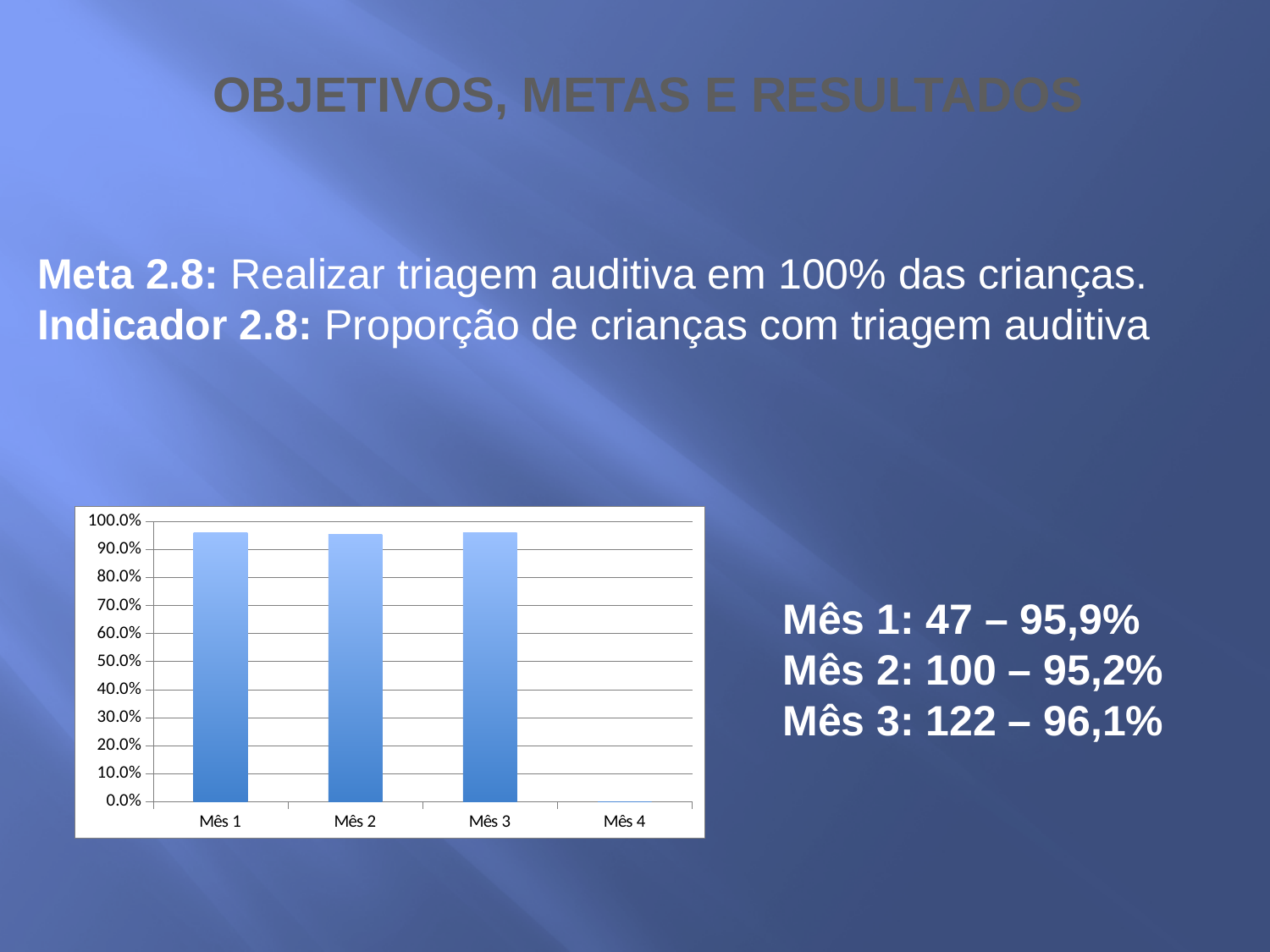
What is the value for Mês 3? 96,1% What is the difference between the values for Mês 3 and Mês 2? 0,9% What kind of chart is shown on the slide? bar chart Which month has the lowest value among the plotted bars? Mês 2 How many categories are shown on the x axis of the chart? 4 Which category on the x axis has no bar plotted? Mês 4 What is the value for Mês 2? 95,2% Is the value for Mês 2 greater or less than 100%? less Is the value for Mês 1 greater or less than 90%? greater What is the highest tick shown on the y axis? 100.0% Which month has the highest value among the plotted bars? Mês 3 What is the value for Mês 1? 95,9%